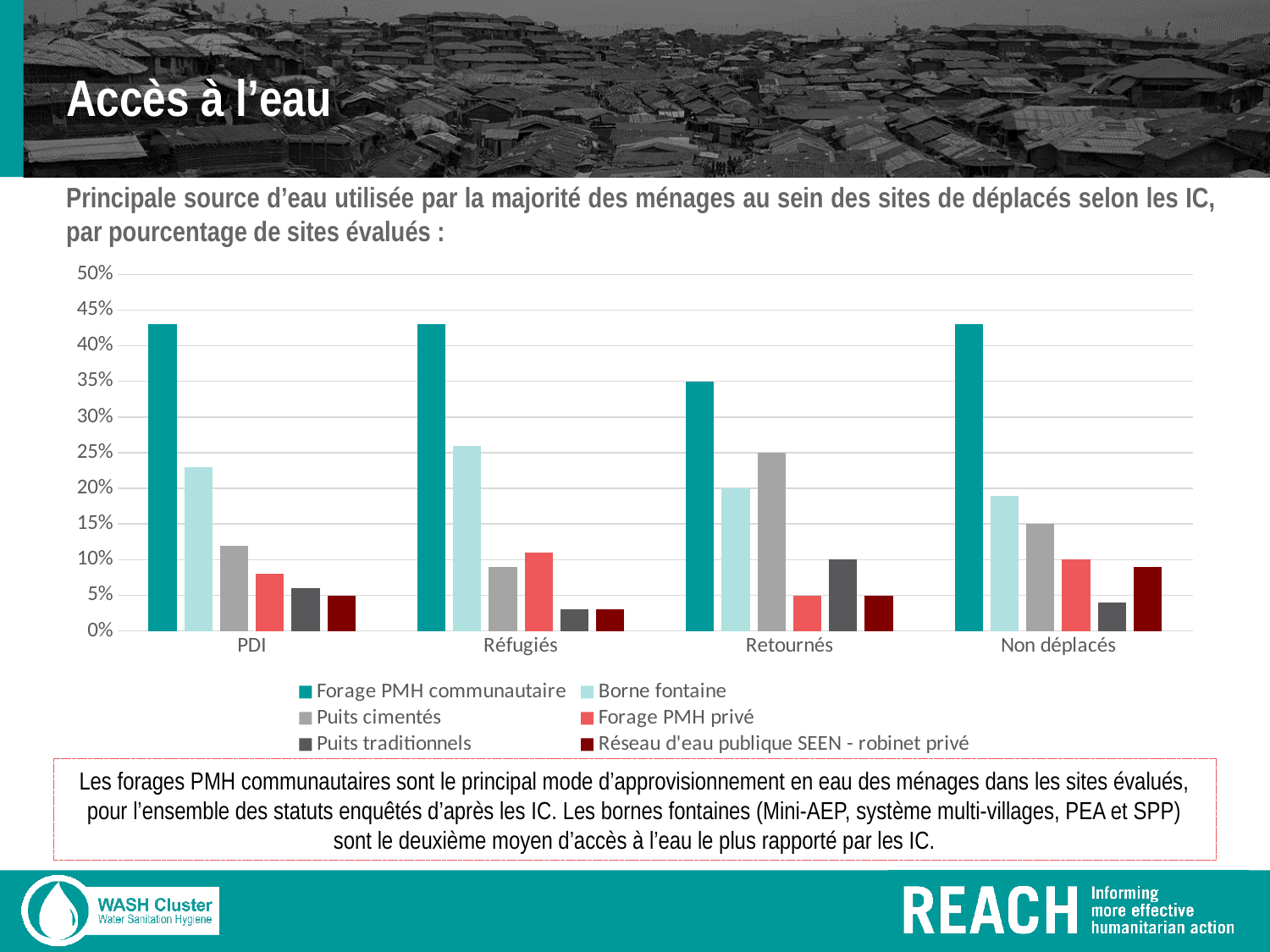
Is the value for Puits cimentés in the PDI category greater or less than 15%? less How many series does the legend list? 6 Which is larger for the Retournés category: Borne fontaine or Puits cimentés? Puits cimentés Which is larger for the Réfugiés category: Puits cimentés or Forage PMH privé? Forage PMH privé Is the value for Borne fontaine in the Réfugiés category greater or less than 20%? greater Is the value for Forage PMH communautaire in the PDI category greater or less than 40%? greater Which series has the lowest value for the Non déplacés category? Puits traditionnels Which series has the highest value for the Retournés category? Forage PMH communautaire What kind of chart is shown on the slide? Bar chart What is the value for Puits cimentés in the Retournés category? 25% How many categories are shown on the x axis? 4 Which series is shown in the darkest red colour in the legend? Réseau d'eau publique SEEN - robinet privé